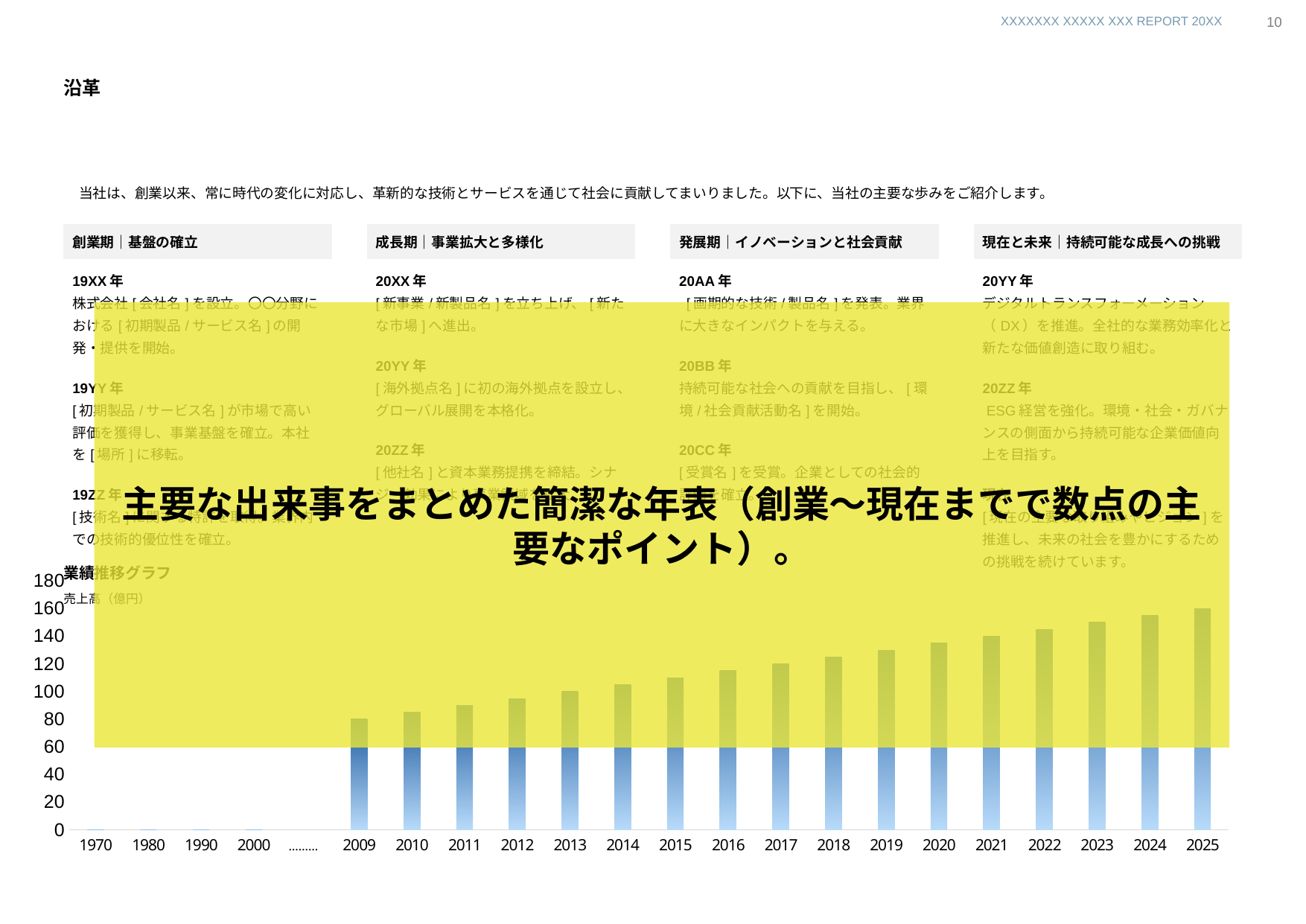
In the 業績推移グラフ, among the years 2009 to 2025, which year has the lowest bar? 2009 What unit label is shown under the title of the 業績推移グラフ? 売上高（億円） In the 業績推移グラフ, is the value for 2024 greater or less than 140? greater What kind of chart is the 業績推移グラフ on the slide? bar chart In the 業績推移グラフ, is the value for 2018 greater or less than 140? less In the 業績推移グラフ, is the value for 2015 greater or less than 100? greater In the 業績推移グラフ, what is the value for 2009? 80 In the 業績推移グラフ, how many consecutive years are labeled on the x axis from 2009 to 2025? 17 In the 業績推移グラフ, which year has the larger bar, 2012 or 2018? 2018 In the 業績推移グラフ, do the bar values rise or fall from 2009 to 2025? rise In the 業績推移グラフ, which year has the highest bar? 2025